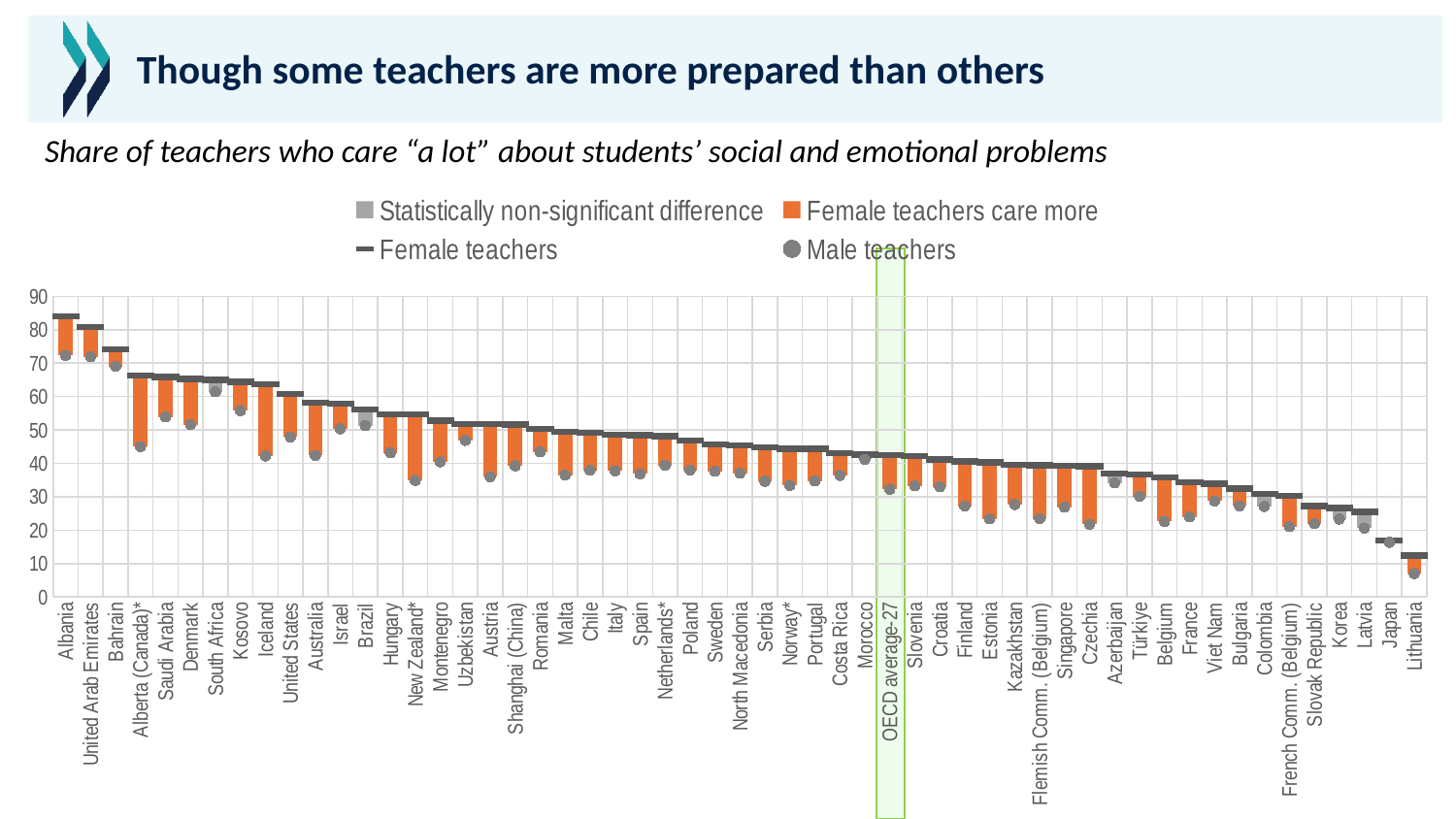
Is the value for female teachers in Lithuania greater or less than 20? less Is the value for male teachers in Japan greater or less than 20? less Which country has the highest share of female teachers who care "a lot" about students' social and emotional problems? Albania How many entries does the legend list? 4 Is the value for female teachers in Albania greater or less than 80? greater Do the values for female teachers rise or fall from left to right along the x axis? fall Which is larger, the share of female teachers in Albania or in Lithuania? Albania Which country has the lowest share of female teachers who care "a lot" about students' social and emotional problems? Lithuania What kind of chart is shown on the slide? bar chart Which category is highlighted with a green box on the chart? OECD average-27